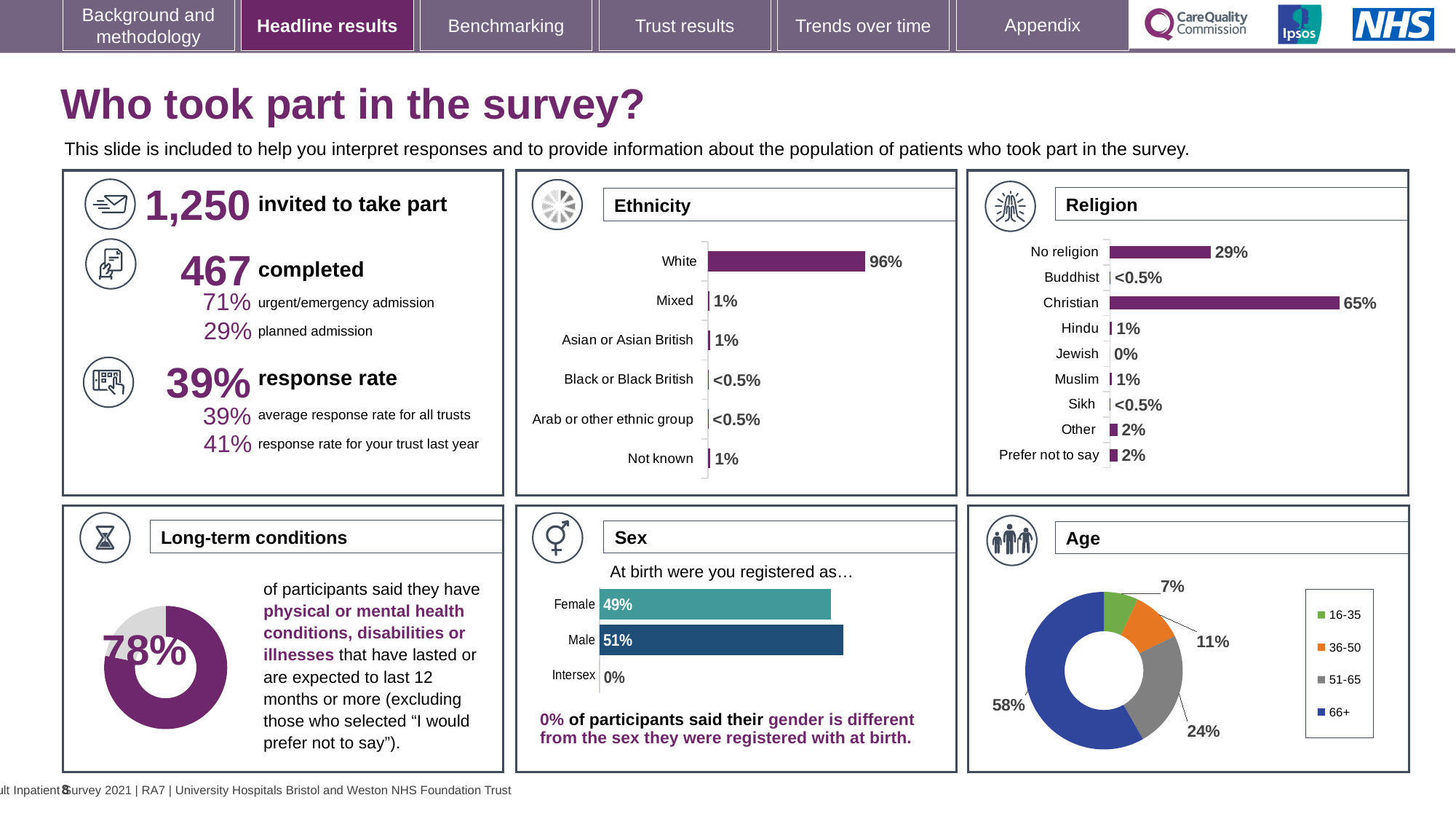
In the Sex chart, which is larger, Female or Male? Male How many categories are shown in the Religion chart? 9 In the Sex chart, what percentage of participants were registered as Male at birth? 51% What kind of chart is the Age chart? Donut chart How many age groups does the legend of the Age chart list? 4 How many categories are shown in the Ethnicity chart? 6 In the Age chart, what share of participants were aged 66+? 58% In the Religion chart, which is larger, Other or Hindu? Other In the Religion chart, what is the difference between the Christian and No religion values? 36% In the Ethnicity chart, which category has the highest value? White In the Ethnicity chart, what percentage of participants were White? 96% In the Religion chart, what percentage of participants were Christian? 65%